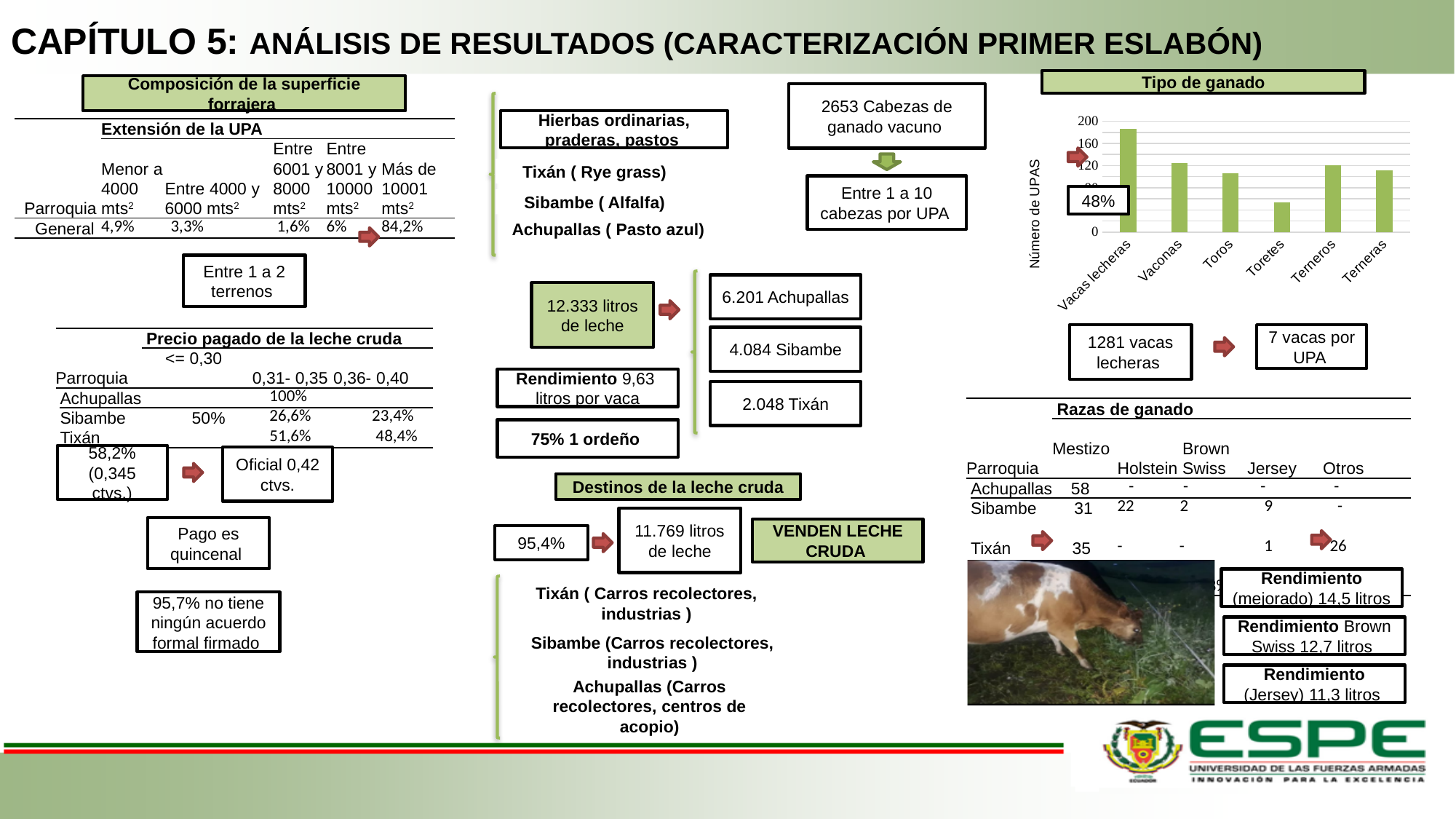
What kind of chart is the 'Tipo de ganado' chart? bar chart In the 'Tipo de ganado' chart, is the value for Vacas lecheras greater or less than 160? greater In the 'Tipo de ganado' chart, which category has the highest number of UPAS? Vacas lecheras In the 'Tipo de ganado' chart, which is larger, the value for Toros or the value for Toretes? Toros In the 'Tipo de ganado' chart, which is larger, the value for Vacas lecheras or the value for Vaconas? Vacas lecheras How many categories are shown on the x axis of the 'Tipo de ganado' chart? 6 What is the highest tick value shown on the y axis of the 'Tipo de ganado' chart? 200 In the 'Tipo de ganado' chart, is the value for Toretes greater or less than 120? less In the 'Tipo de ganado' chart, which category has the lowest number of UPAS? Toretes What is the label of the y axis of the 'Tipo de ganado' chart? Número de UPAS In the 'Tipo de ganado' chart, which is larger, the value for Terneros or the value for Toretes? Terneros In the 'Tipo de ganado' chart, is the value for Toros greater or less than 120? less